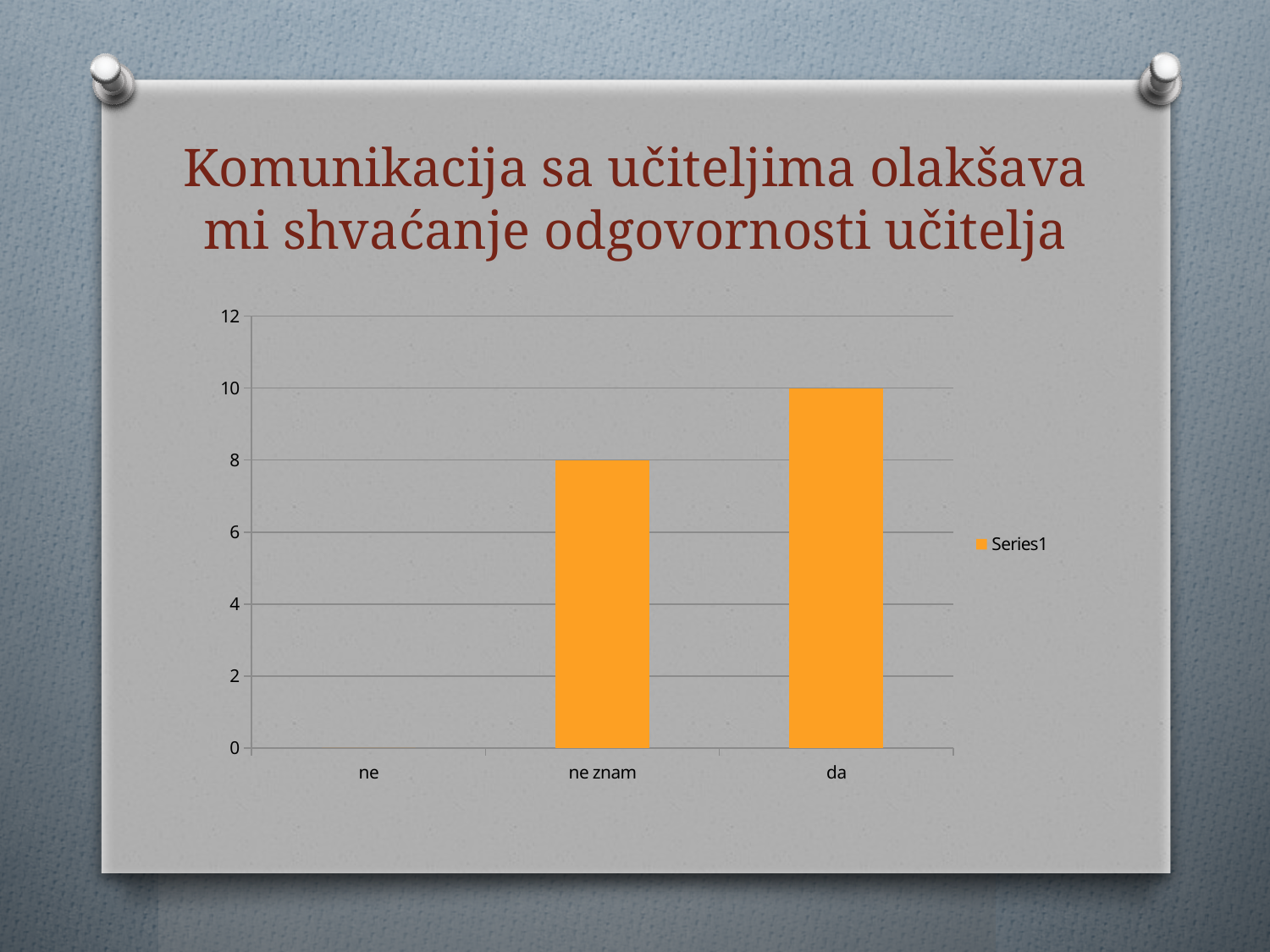
How many categories are shown on the x axis? 3 What is the name of the series shown in the legend? Series1 Is the value for "ne znam" greater or less than 6? greater What is the value for "da"? 10 What is the value for "ne znam"? 8 What is the value for "ne"? 0 Which is larger, the value for "ne znam" or the value for "da"? da Which category has the lowest value? ne What kind of chart is shown on the slide? bar chart How many series does the legend list? 1 Which category has the highest value? da What is the difference between the values for "da" and "ne znam"? 2